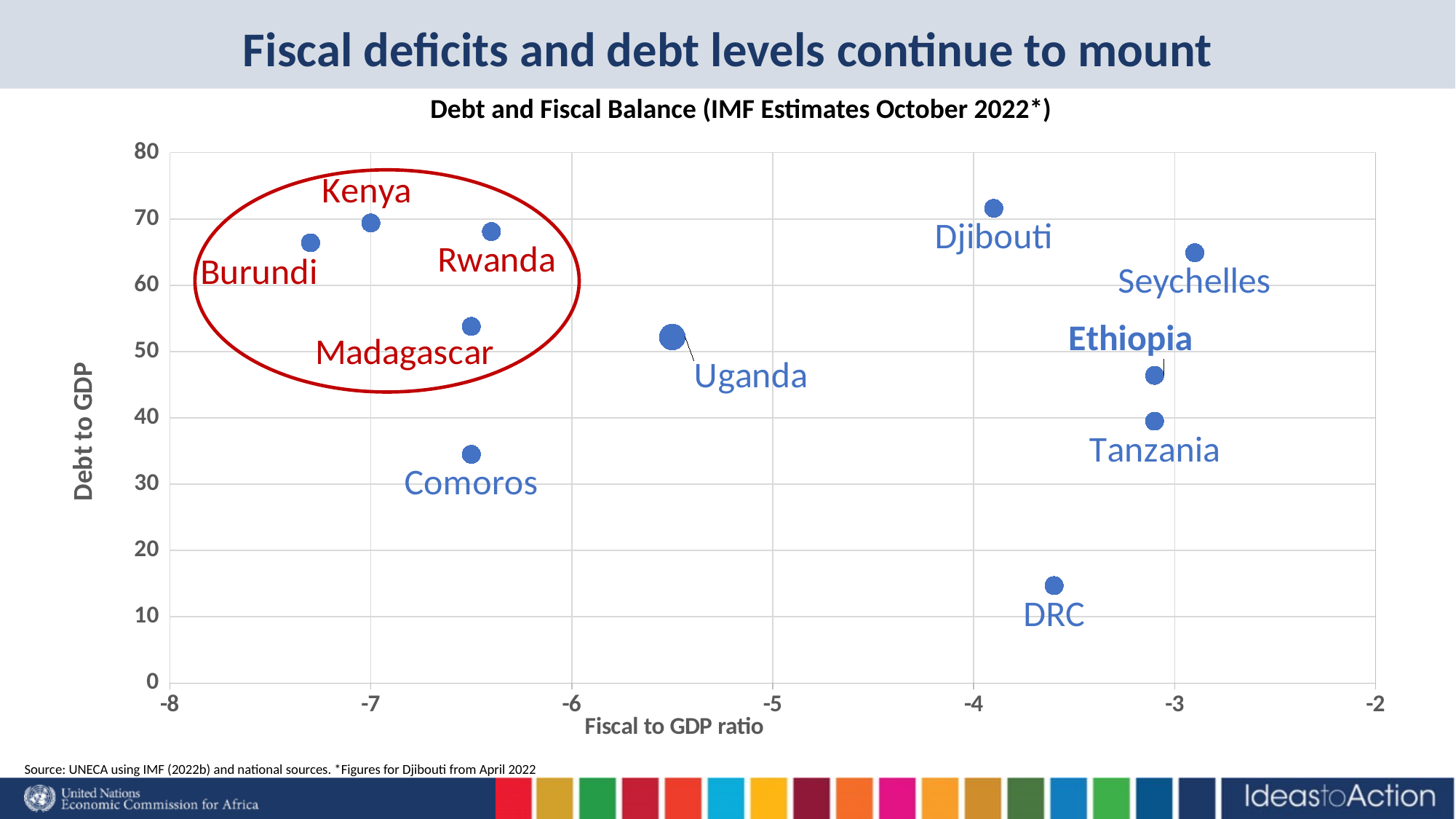
Is the Debt to GDP value for Djibouti greater or less than 70? greater Is the Debt to GDP value for Comoros greater or less than 40? less What is the title of the chart? Debt and Fiscal Balance (IMF Estimates October 2022*) How many countries are plotted on the chart? 11 Is the Debt to GDP value for DRC greater or less than 20? less Which has a higher Debt to GDP value, Rwanda or Comoros? Rwanda Which country has the lowest Debt to GDP value? DRC What kind of chart is shown on the slide? scatter chart Which has a higher Debt to GDP value, Kenya or Madagascar? Kenya Which country has the highest Debt to GDP value? Djibouti